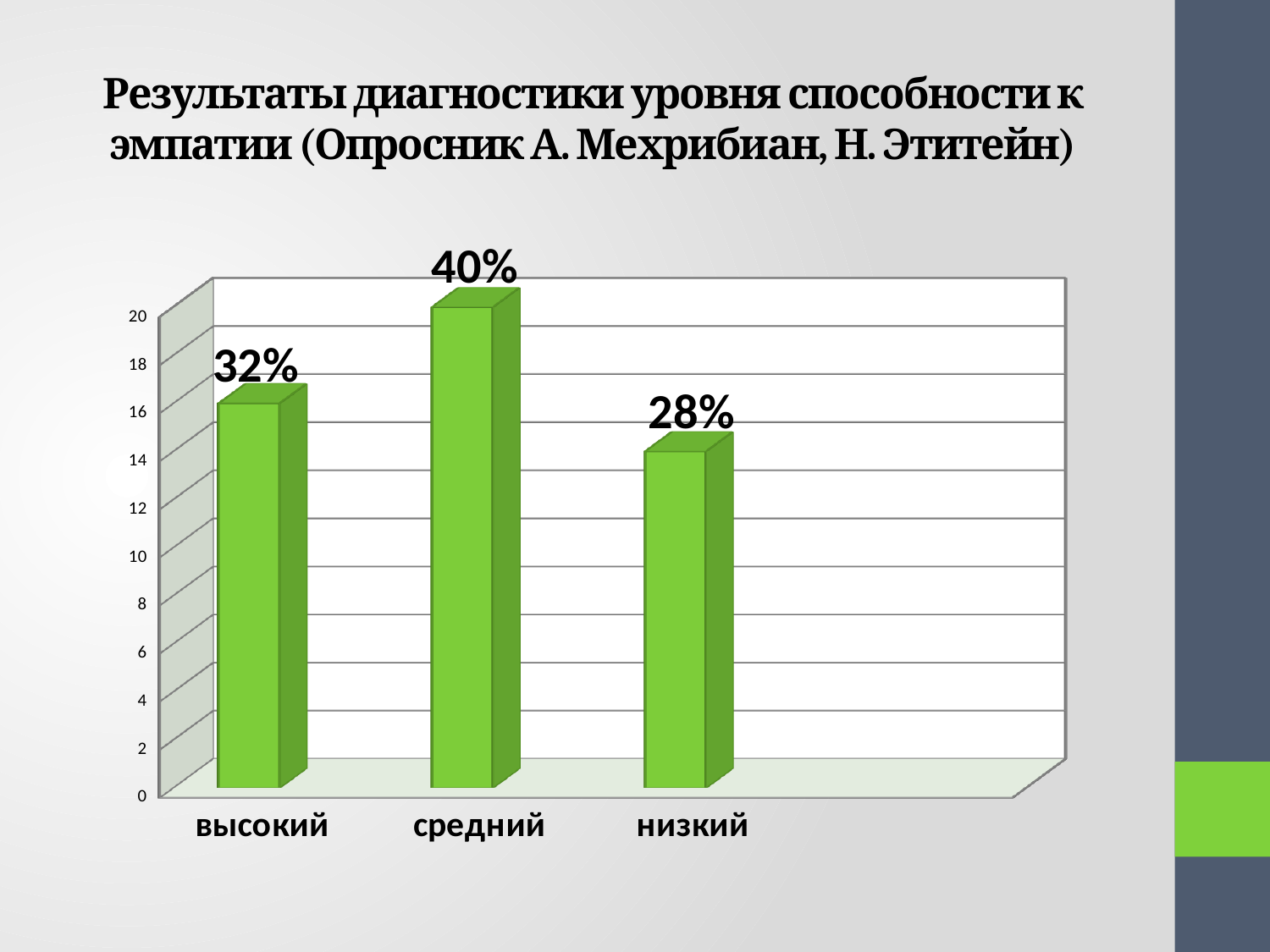
What is the data label shown for the category "высокий"? 32% What colour are the bars in the chart? green What kind of chart is shown on the slide? bar chart What is the difference between the labelled values for "средний" and "высокий"? 8% Which is larger, the value for "высокий" or the value for "низкий"? высокий Which category has the highest value? средний Which category has the lowest value? низкий What is the data label shown for the category "средний"? 40% What is the difference between the labelled values for "высокий" and "низкий"? 4% How many categories are shown on the x axis? 3 Is the bar for "низкий" greater or less than 10 on the vertical axis? greater What is the data label shown for the category "низкий"? 28%